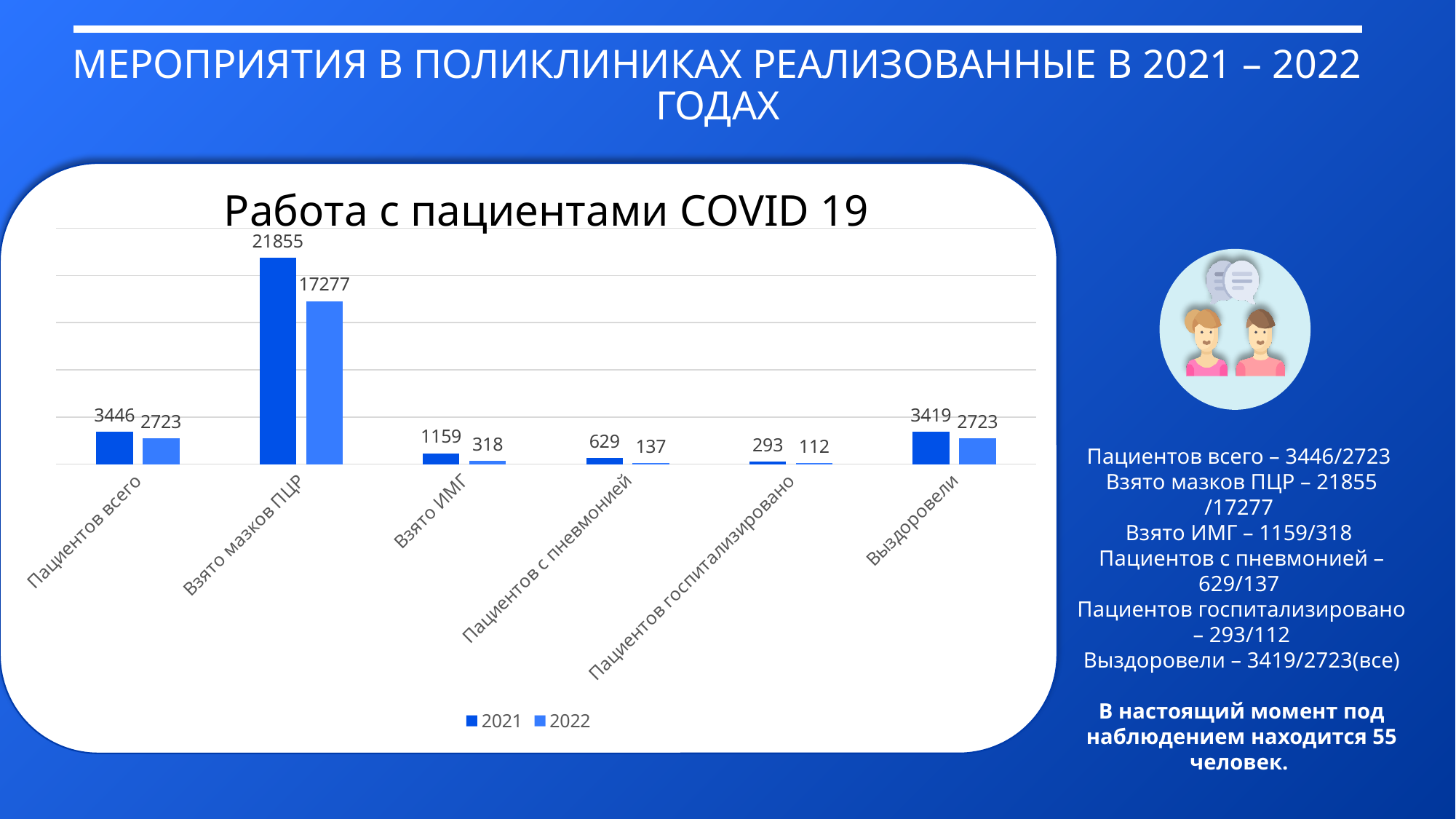
What is the difference between the 2021 and 2022 values for 'Пациентов с пневмонией'? 492 What is the title of the chart? Работа с пациентами COVID 19 How many series does the legend list? 2 Which is larger: the 2021 value for 'Пациентов всего' or the 2021 value for 'Выздоровели'? Пациентов всего What is the difference between the 2021 and 2022 values for 'Взято мазков ПЦР'? 4578 Which category has the lowest value for the 2022 series? Пациентов госпитализировано Which category has the highest value for the 2021 series? Взято мазков ПЦР What is the value for 2021 in the 'Взято мазков ПЦР' category? 21855 What kind of chart is shown on the slide? bar chart How many categories are shown on the x axis of the chart? 6 What is the value for 2022 in the 'Взято ИМГ' category? 318 What is the value for 2022 in the 'Пациентов госпитализировано' category? 112